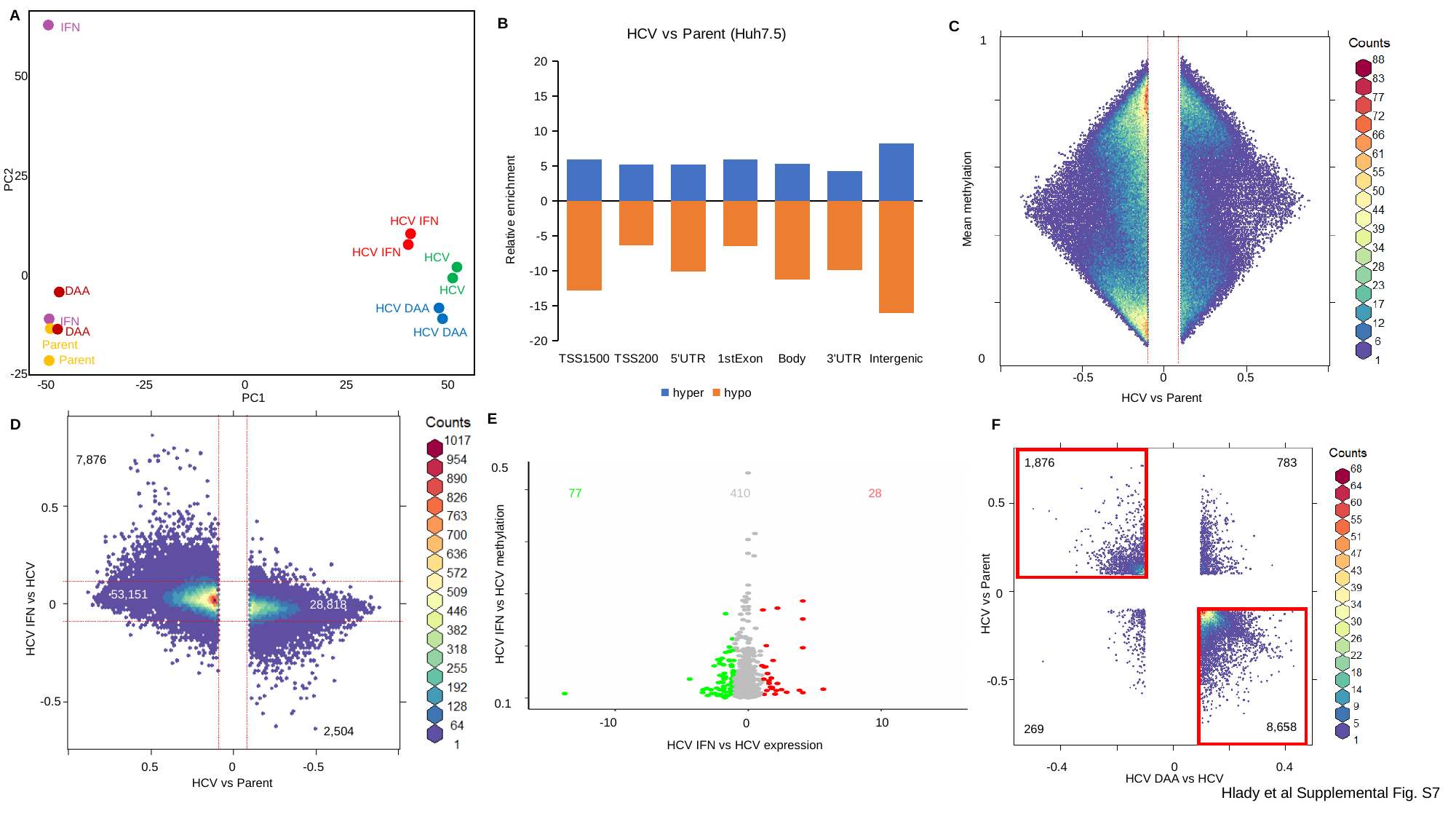
In panel B (HCV vs Parent (Huh7.5)), how many series does the legend list? 2 In panel D, what count is printed in the upper-left region of the plot? 7,876 In panel B (HCV vs Parent (Huh7.5)), is the hypo value for TSS1500 greater or less than -10? less In panel B (HCV vs Parent (Huh7.5)), how many genomic region categories are shown on the x axis? 7 In panel B (HCV vs Parent (Huh7.5)), what kind of chart is shown? bar chart In panel B (HCV vs Parent (Huh7.5)), which category has the highest hyper relative enrichment? Intergenic In panel B (HCV vs Parent (Huh7.5)), which series is shown in orange? hypo In panel F, what count is printed in the lower-right red box? 8,658 In panel B (HCV vs Parent (Huh7.5)), is the hyper value for Intergenic greater or less than 5? greater In panel E, what number is printed in green on the left side of the plot? 77 In panel A, what is the label of the x axis? PC1 In panel B (HCV vs Parent (Huh7.5)), which category has the lowest (most negative) hypo relative enrichment? Intergenic